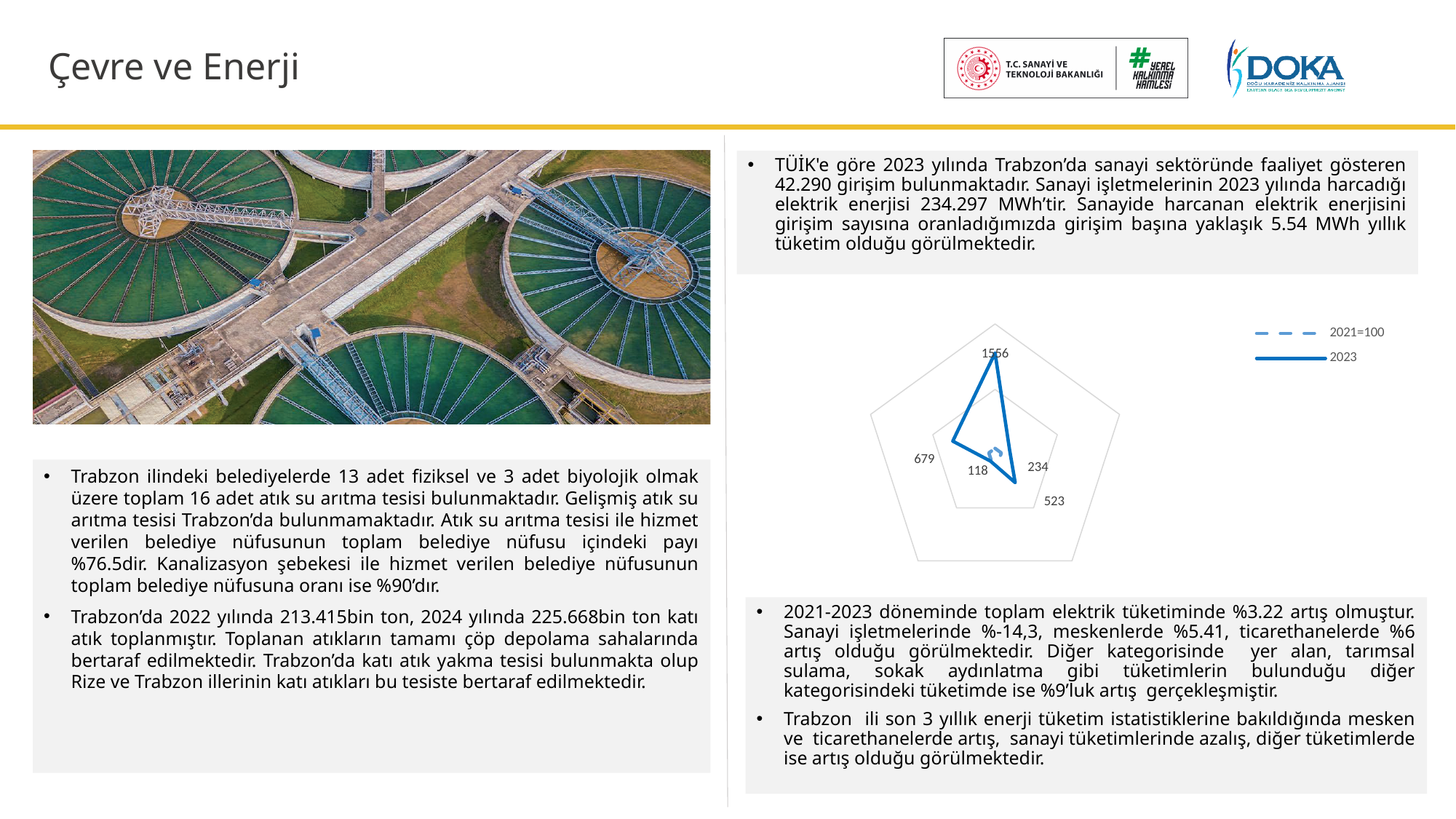
What is the difference between the largest and smallest values labelled on the radar chart? 1438 What is the smallest value labelled on the radar chart? 118 Which legend entry of the radar chart is drawn with a dashed line? 2021=100 How many axes (corners) does the radar chart's pentagon have? 5 On the radar chart, which is larger: the value labelled 234 or the value labelled 118? 234 How many series does the legend of the radar chart list? 2 What are the two legend entries of the radar chart? 2021=100 and 2023 What kind of chart is shown on the right side of the slide? radar chart On the radar chart, which is larger: the value labelled 679 or the value labelled 523? 679 How many data points are labelled on the radar chart? 5 What is the largest value labelled on the radar chart? 1556